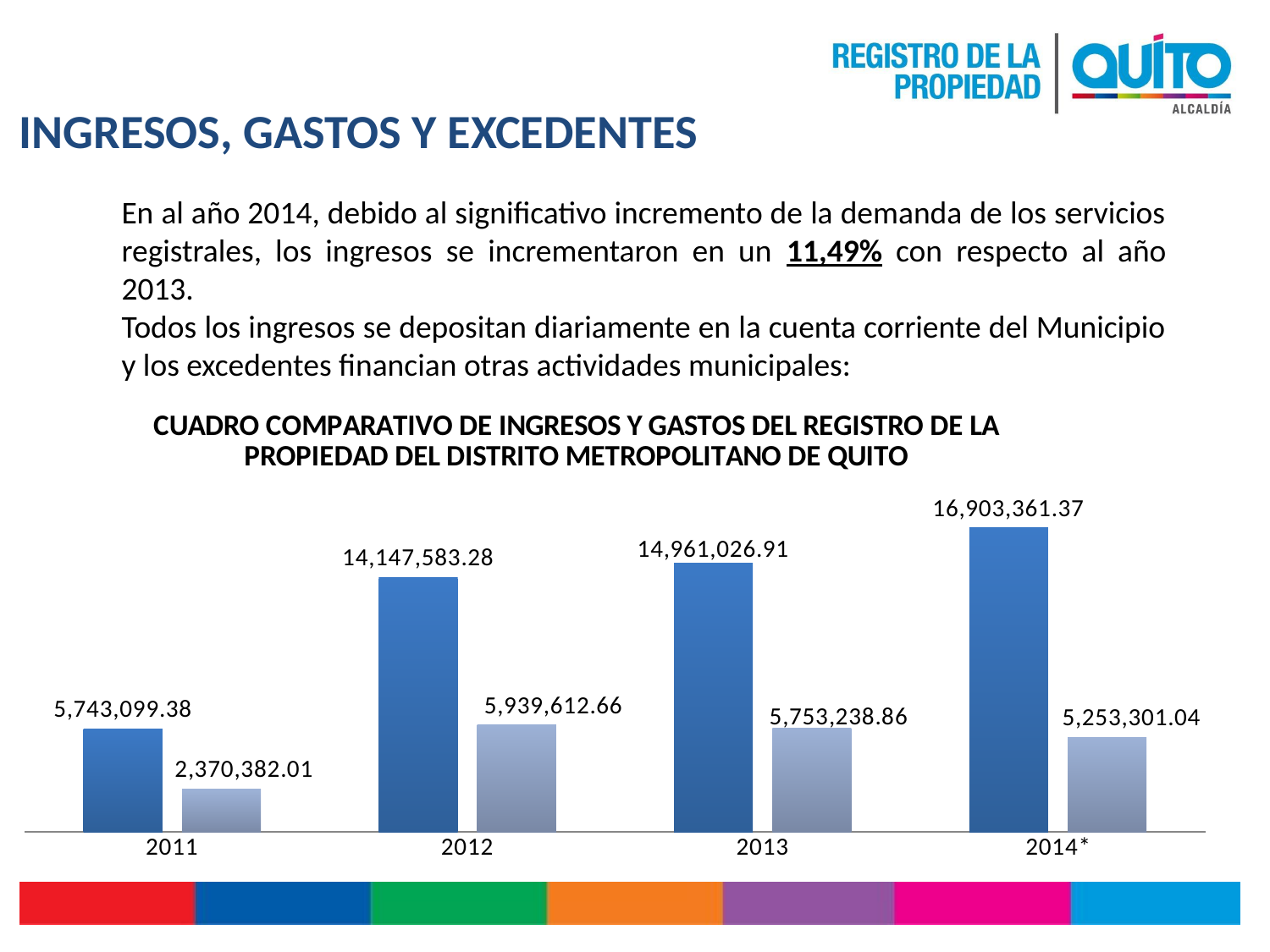
What kind of chart is shown on the slide? bar chart In which year is the light blue bar the lowest? 2011 What is the value of the light blue bar for 2011? 2,370,382.01 Do the dark blue bars rise or fall from 2011 to 2014*? rise What is the value of the dark blue bar for 2011? 5,743,099.38 Which is larger: the light blue bar for 2012 or the light blue bar for 2014*? 2012 How many years are shown on the x axis of the chart? 4 What is the value of the dark blue bar for 2014*? 16,903,361.37 What is the value of the light blue bar for 2013? 5,753,238.86 In which year is the dark blue bar the highest? 2014* What is the difference between the dark blue and light blue bars for 2014*? 11,650,060.33 What is the title of the chart? CUADRO COMPARATIVO DE INGRESOS Y GASTOS DEL REGISTRO DE LA PROPIEDAD DEL DISTRITO METROPOLITANO DE QUITO